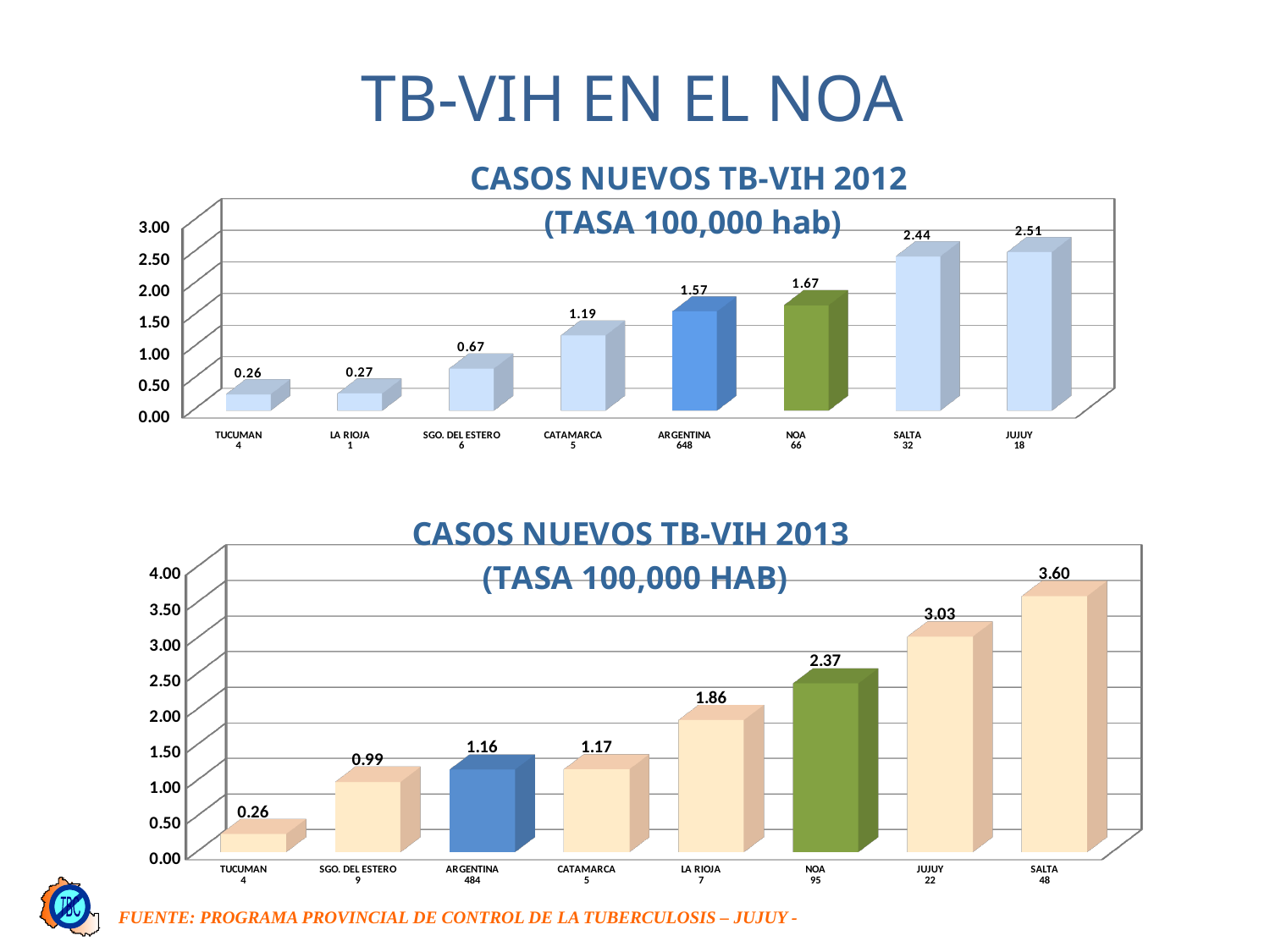
In the CASOS NUEVOS TB-VIH 2012 chart, how many categories are shown on the x axis? 8 In the CASOS NUEVOS TB-VIH 2013 chart, do the values rise or fall from left to right along the x axis? Rise In the CASOS NUEVOS TB-VIH 2012 chart, what is the value for SALTA? 2.44 In the CASOS NUEVOS TB-VIH 2013 chart, what is the value for ARGENTINA? 1.16 In the CASOS NUEVOS TB-VIH 2013 chart, which category has the lowest value? TUCUMAN In the CASOS NUEVOS TB-VIH 2012 chart, what is the value for NOA? 1.67 In the CASOS NUEVOS TB-VIH 2013 chart, which is larger, the value for NOA or the value for JUJUY? JUJUY What kind of chart is the CASOS NUEVOS TB-VIH 2013 chart? Bar chart In the CASOS NUEVOS TB-VIH 2013 chart, what is the value for LA RIOJA? 1.86 In the CASOS NUEVOS TB-VIH 2012 chart, what is the difference between the values for JUJUY and SALTA? 0.07 In the CASOS NUEVOS TB-VIH 2012 chart, which category has the highest value? JUJUY In the CASOS NUEVOS TB-VIH 2013 chart, what is the difference between the values for SALTA and JUJUY? 0.57